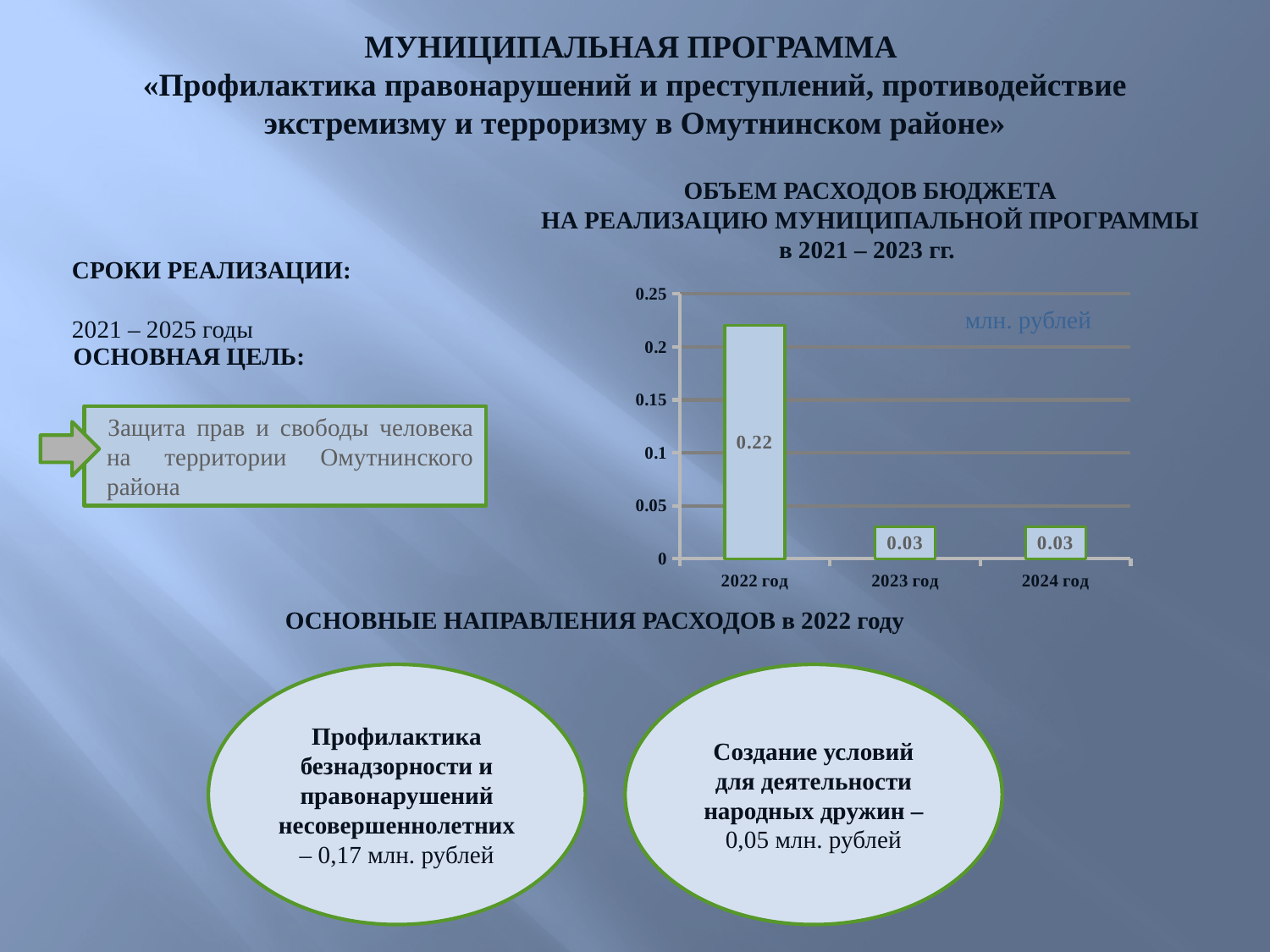
Do the values rise or fall from 2022 год to 2023 год? fall Which is larger, the value for 2022 год or the value for 2024 год? 2022 год What unit is indicated on the chart? млн. рублей Is the value for 2022 год greater or less than 0.2? greater What is the value for 2024 год in the chart? 0.03 How many years (categories) are shown in the chart? 3 What is the value for 2022 год in the chart? 0.22 Is the value for 2023 год greater or less than 0.05? less Which year has the highest value in the chart? 2022 год What is the value for 2023 год in the chart? 0.03 What is the difference between the values for 2022 год and 2023 год? 0.19 What kind of chart is shown on the slide? bar chart